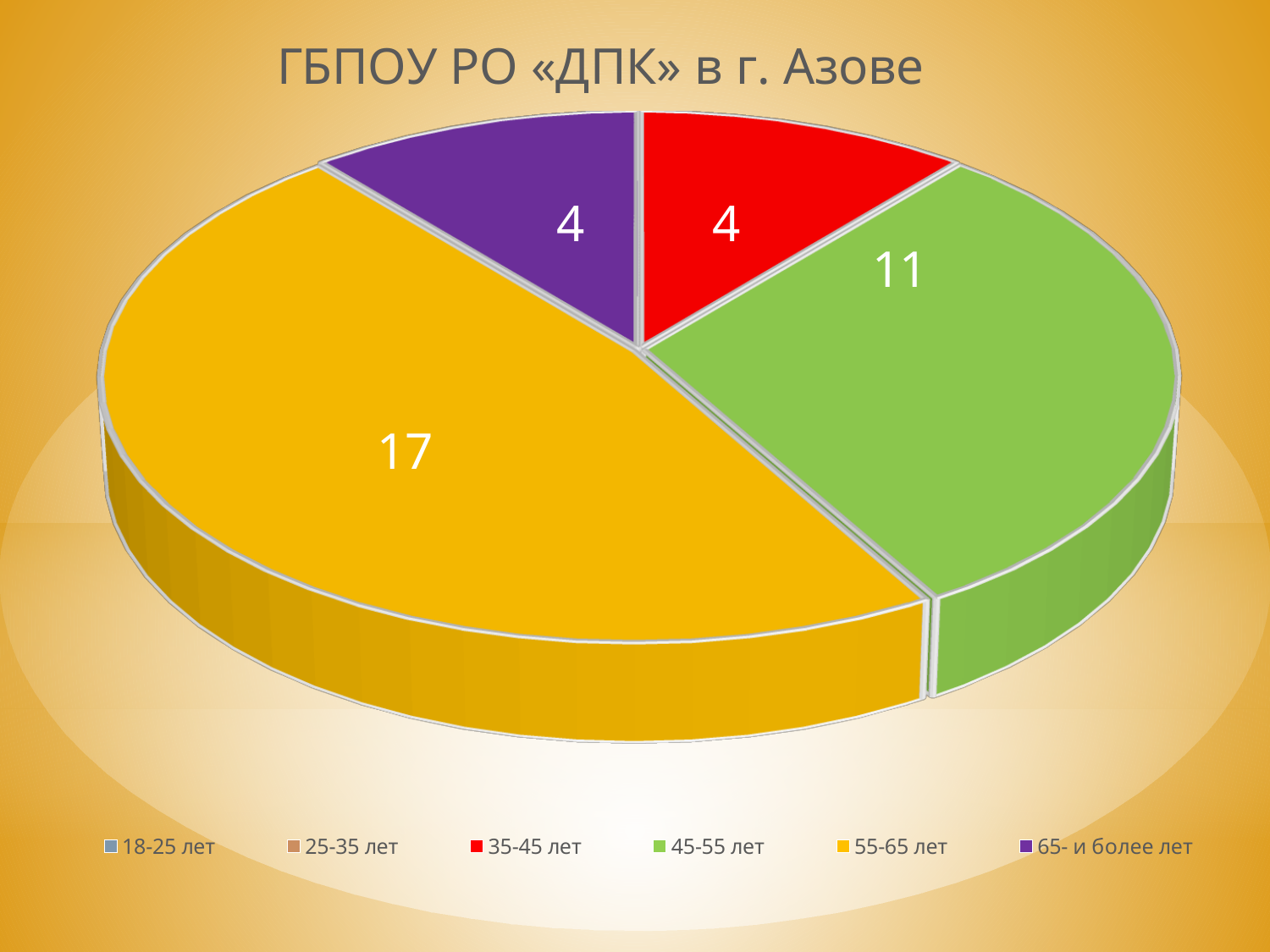
What is the value for the 55-65 лет slice? 17 What is the title of the chart? ГБПОУ РО «ДПК» в г. Азове Which is larger, the 45-55 лет slice or the 65- и более лет slice? 45-55 лет What is the value for the 45-55 лет slice? 11 What kind of chart is shown on the slide? Pie chart What is the value for the 35-45 лет slice? 4 What is the difference between the 45-55 лет and 35-45 лет values? 7 What is the value for the 65- и более лет slice? 4 How many categories does the legend list? 6 What colour is the 45-55 лет slice? Green What is the difference between the 55-65 лет and 45-55 лет values? 6 Which category has the largest slice? 55-65 лет